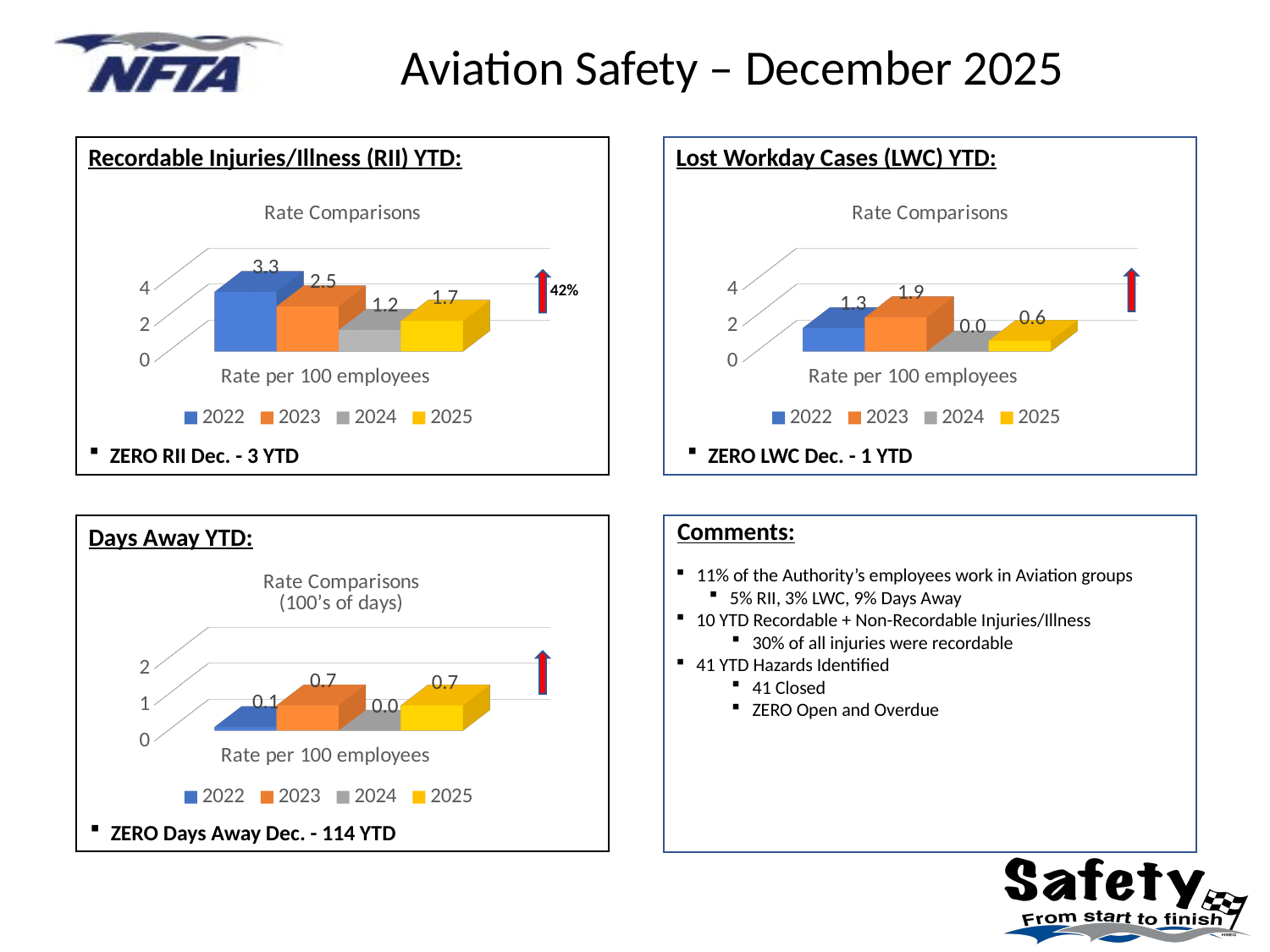
In the Recordable Injuries/Illness (RII) YTD chart, what is the difference between the 2022 and 2023 rates? 0.8 In the Lost Workday Cases (LWC) YTD chart, what is the rate for 2023? 1.9 In the Recordable Injuries/Illness (RII) YTD chart, what is the rate for 2025? 1.7 In the Lost Workday Cases (LWC) YTD chart, what is the rate for 2024? 0.0 What kind of chart is the Lost Workday Cases (LWC) YTD chart? Bar chart In the Recordable Injuries/Illness (RII) YTD chart, which year has the highest rate? 2022 In the Lost Workday Cases (LWC) YTD chart, which is larger, the 2022 rate or the 2025 rate? 2022 In the Recordable Injuries/Illness (RII) YTD chart, which year has the lowest rate? 2024 How many series does the legend list in the Days Away YTD chart? 4 What is the x-axis category label in the Recordable Injuries/Illness (RII) YTD chart? Rate per 100 employees In the Days Away YTD chart, what is the difference between the 2023 and 2022 rates? 0.6 In the Days Away YTD chart, what is the rate for 2022? 0.1